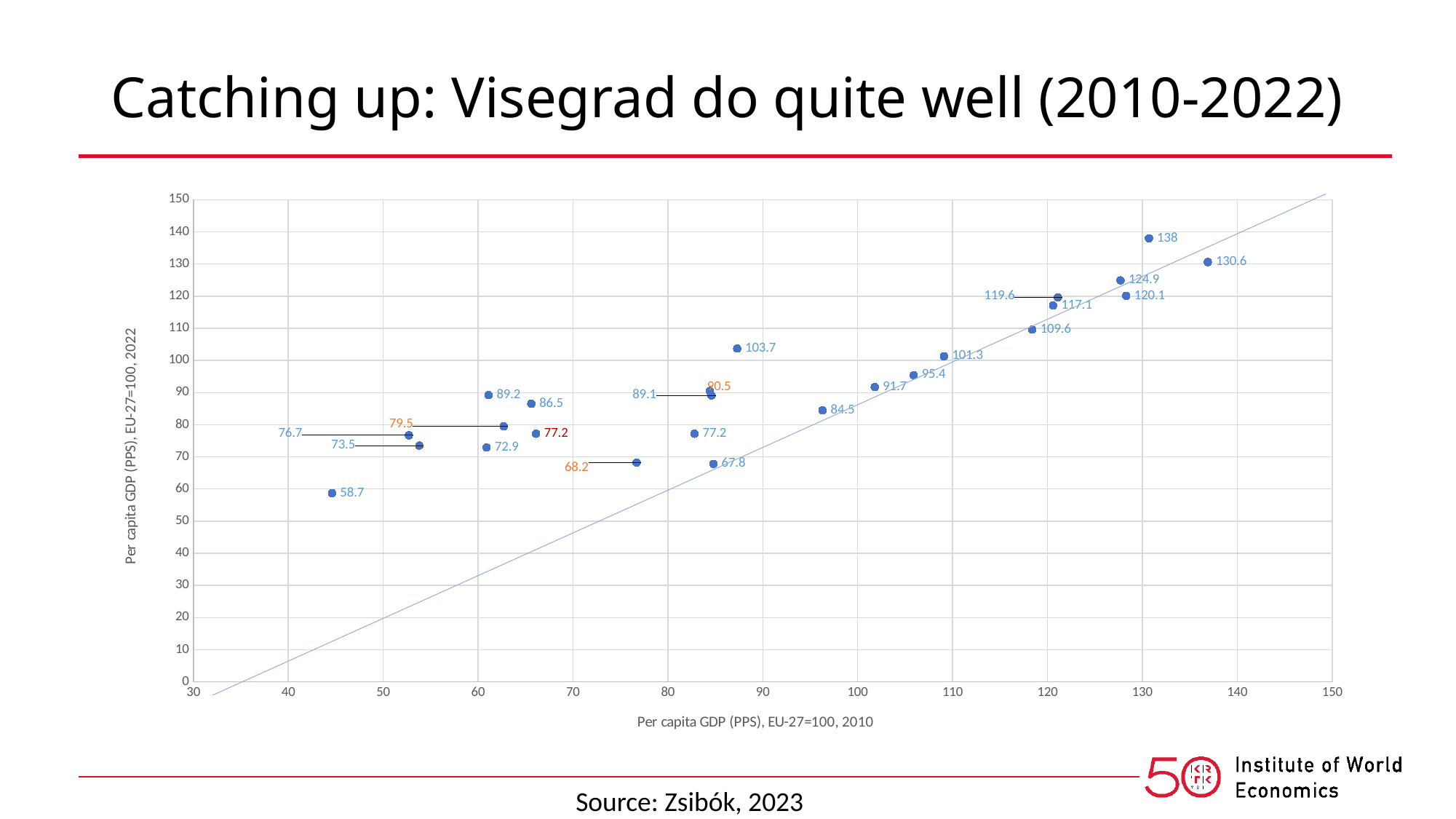
Is the 2010 (x-axis) value of the point labelled 130.6 greater or less than 130? greater What is the difference between the highest labelled value (138) and the lowest labelled value (58.7)? 79.3 What kind of chart is shown on the slide? scatter chart What is the difference between the two highest labelled values, 138 and 130.6? 7.4 Which is larger, the point labelled 103.7 or the point labelled 101.3? 103.7 What is the highest data label shown on the chart? 138 Do the 2022 values generally rise or fall as the 2010 values increase along the x axis? rise Is the 2010 (x-axis) value of the point labelled 103.7 greater or less than 90? less What is the lowest data label shown on the chart? 58.7 What is the label of the vertical axis? Per capita GDP (PPS), EU-27=100, 2022 Is the 2010 (x-axis) value of the point labelled 58.7 greater or less than 50? less